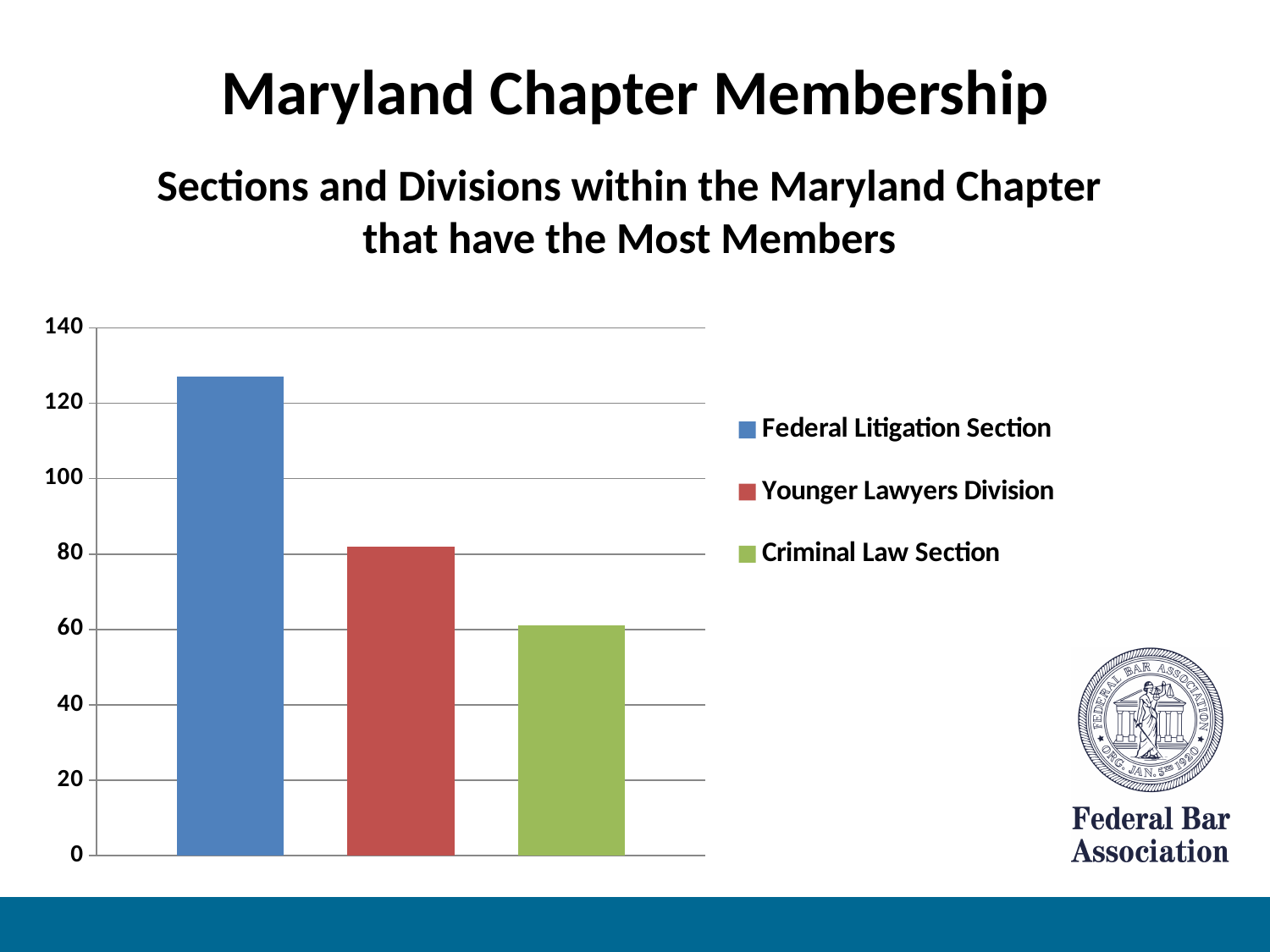
How many bars are plotted in the chart? 3 How many entries does the chart's legend list? 3 Do the bar values rise or fall from left to right across the chart? fall Which has more members, the Federal Litigation Section or the Younger Lawyers Division? Federal Litigation Section Which section or division has the lowest membership in the chart? Criminal Law Section Is the value for the Younger Lawyers Division greater or less than 100? less What colour is the bar for the Criminal Law Section? green Which section or division has the highest membership in the chart? Federal Litigation Section What kind of chart is shown on the slide? bar chart Is the value for the Criminal Law Section greater or less than 80? less Is the value for the Federal Litigation Section greater or less than 120? greater Which has more members, the Younger Lawyers Division or the Criminal Law Section? Younger Lawyers Division